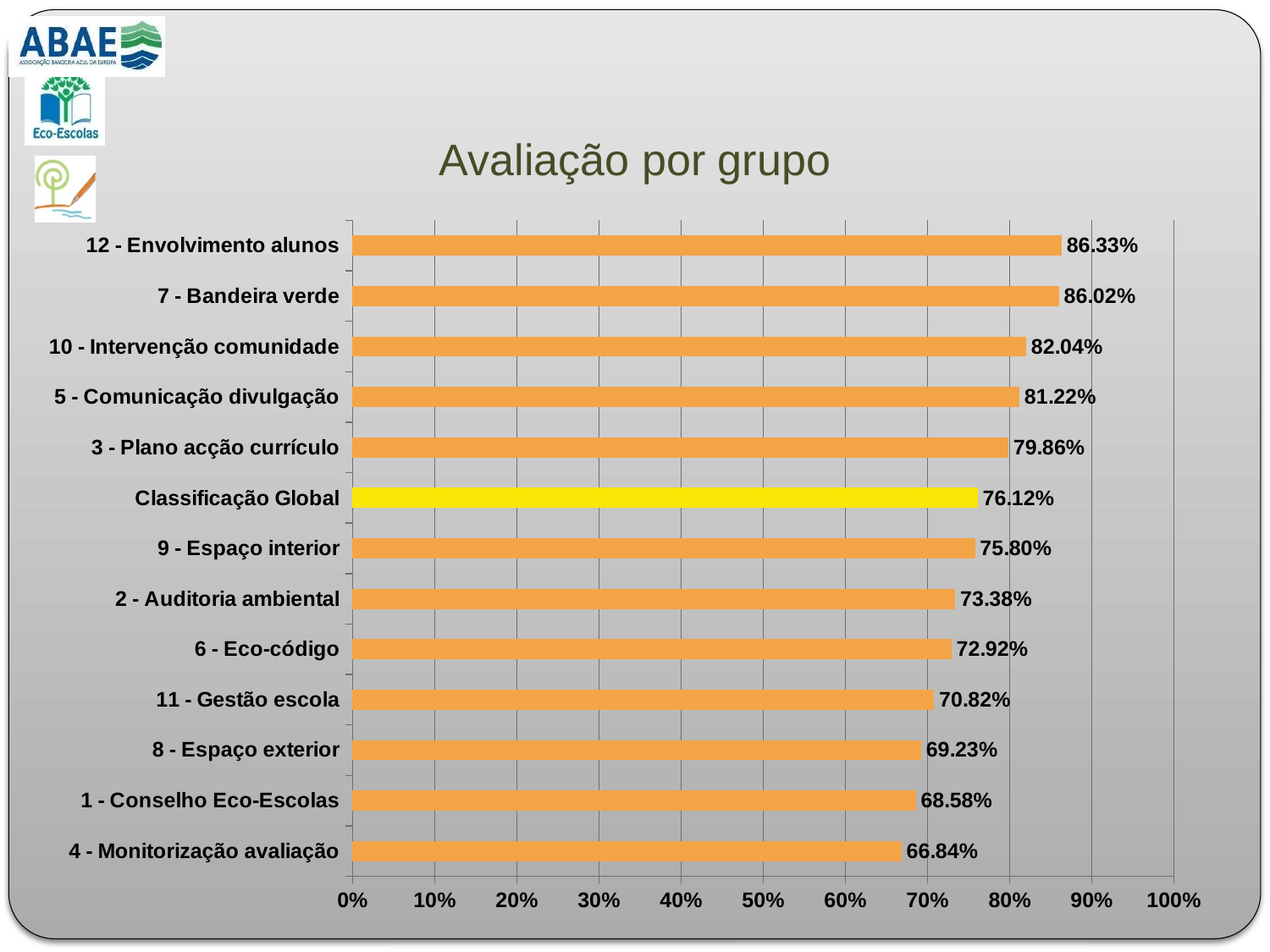
What is the difference between the values for 12 - Envolvimento alunos and 4 - Monitorização avaliação? 19.49 percentage points Which is larger, the value for 3 - Plano acção currículo or the value for 9 - Espaço interior? 3 - Plano acção currículo Which category's bar is coloured yellow instead of orange? Classificação Global What is the value for 12 - Envolvimento alunos? 86.33% Is the value for 2 - Auditoria ambiental greater or less than 80%? less How many categories are shown in the chart? 13 What is the difference between the values for 10 - Intervenção comunidade and 5 - Comunicação divulgação? 0.82 percentage points Which category has the lowest value? 4 - Monitorização avaliação What kind of chart is shown on the slide? bar chart What is the value for Classificação Global? 76.12% Which category has the highest value? 12 - Envolvimento alunos What is the value for 6 - Eco-código? 72.92%